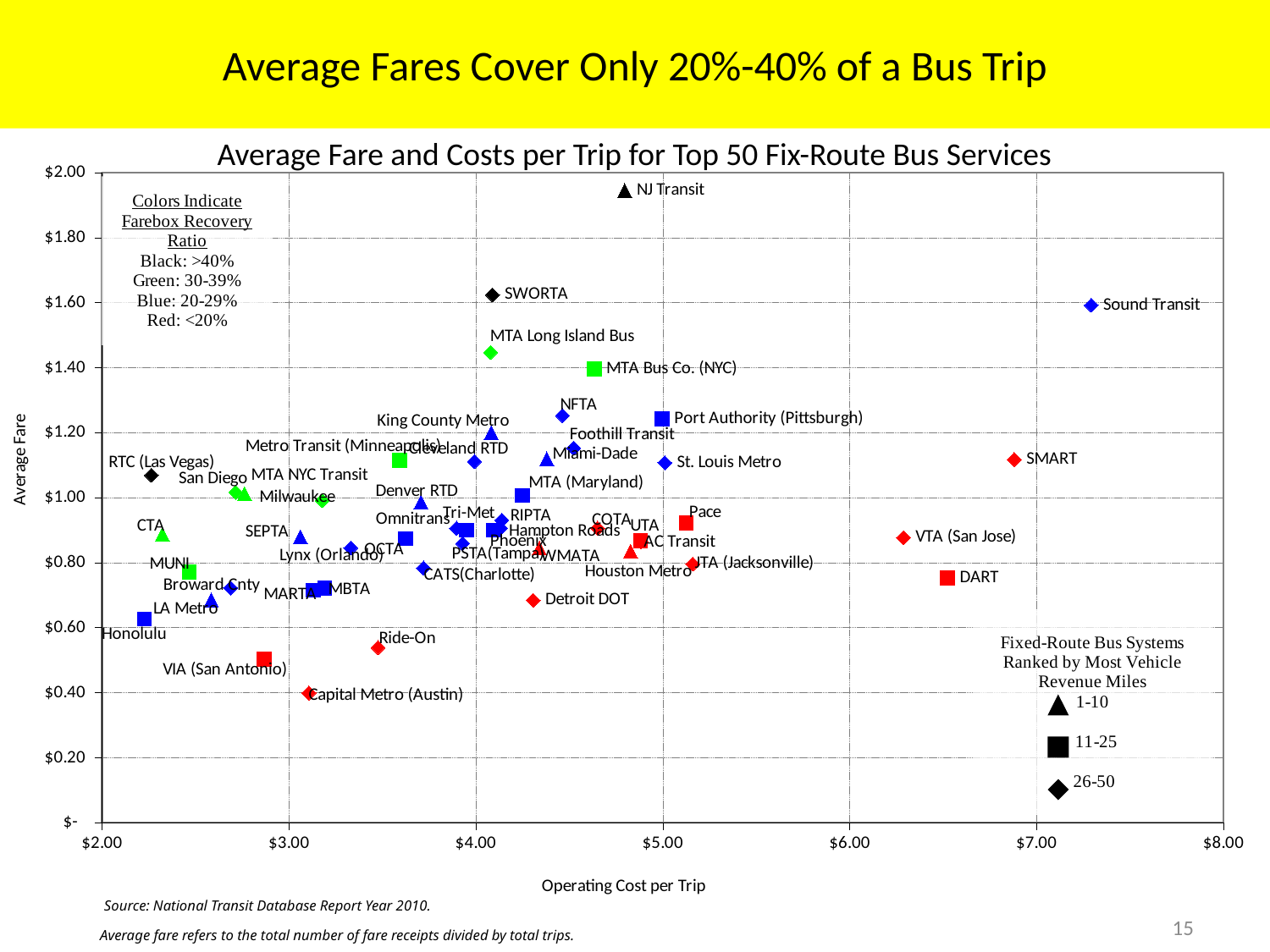
Is the average fare for Capital Metro (Austin) greater or less than $0.60? less Which bus service has the lowest average fare on the chart? Capital Metro (Austin) Is the operating cost per trip for Sound Transit greater or less than $7.00? greater According to the chart's key, which colour indicates a farebox recovery ratio above 40%? Black Which bus service has the highest average fare on the chart? NJ Transit Which has a higher average fare, SWORTA or NJ Transit? NJ Transit Which has a higher operating cost per trip, VTA (San Jose) or Sound Transit? Sound Transit Is the average fare for NJ Transit greater or less than $1.80? greater Which bus service has the lowest operating cost per trip on the chart? Honolulu Which bus service has the highest operating cost per trip on the chart? Sound Transit What kind of chart is shown on the slide? Scatter chart